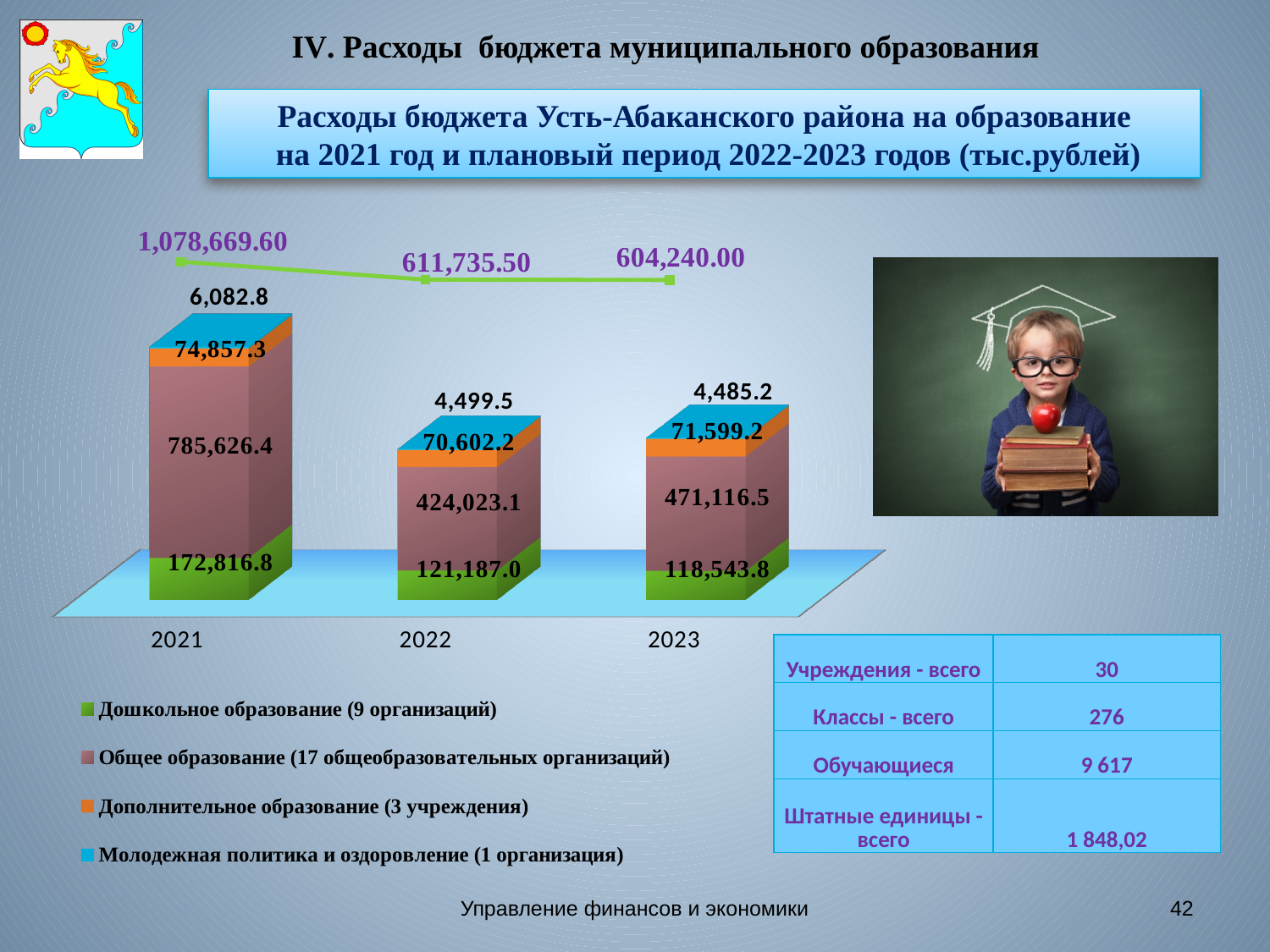
What is the difference between the Общее образование values for 2023 and 2022? 47,093.4 What is the value for Дошкольное образование in 2023? 118,543.8 In which year is the value for Общее образование the highest? 2021 Which is larger: Дополнительное образование in 2021 or in 2023? 2021 How many series does the legend list? 4 What is the value shown on the line above the 2022 bar? 611,735.50 What kind of chart is used to show the education expenditure by year? stacked bar chart What is the value for Общее образование in 2021? 785,626.4 How many years are shown on the x axis of the chart? 3 What is the value for Дополнительное образование in 2022? 70,602.2 What is the value for Молодежная политика и оздоровление in 2021? 6,082.8 In which year is the value for Дошкольное образование the lowest? 2023